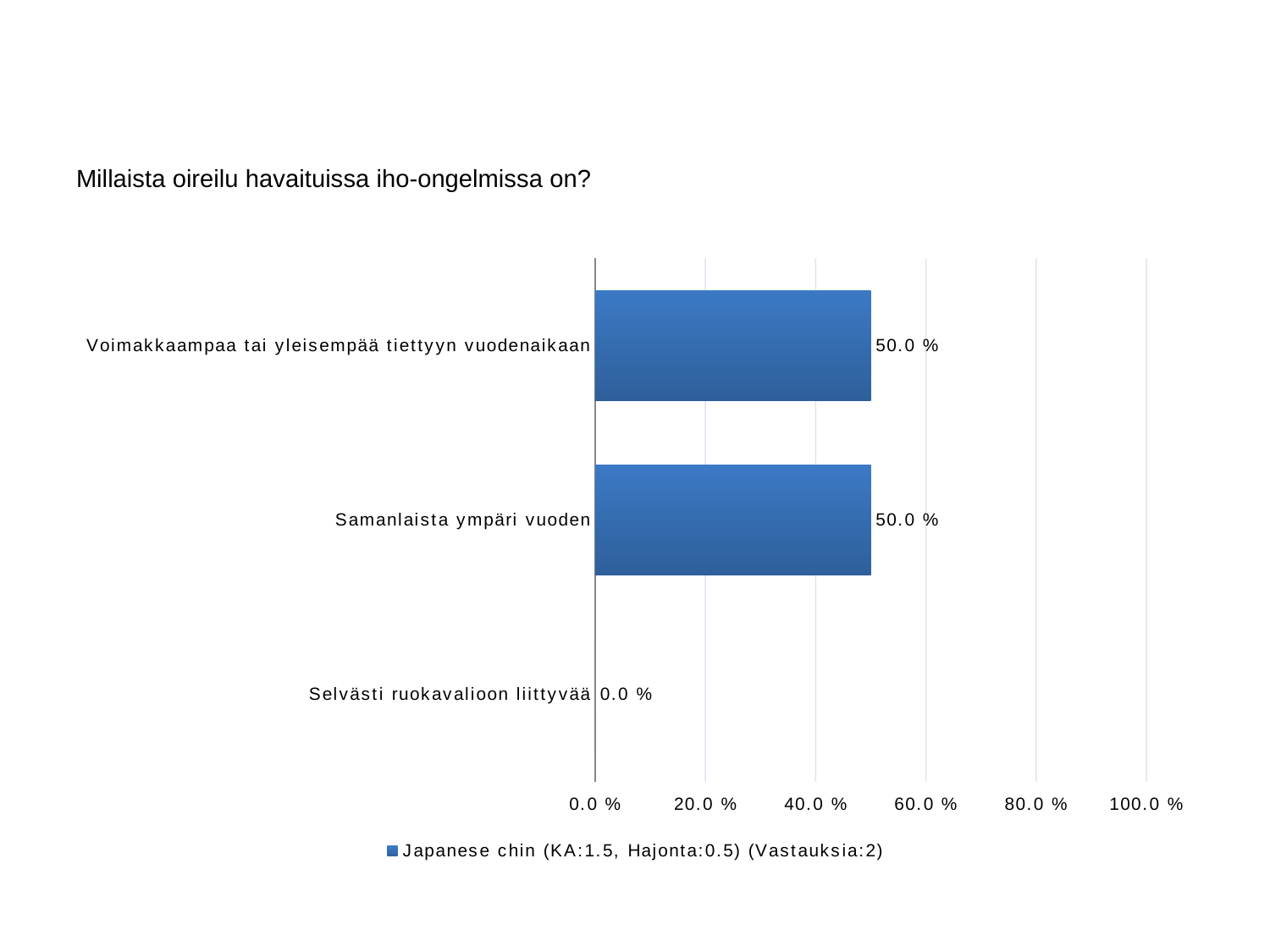
What is the value for "Voimakkaampaa tai yleisempää tiettyyn vuodenaikaan"? 50.0 % What is the value for "Selvästi ruokavalioon liittyvää"? 0.0 % What is the legend entry for the series? Japanese chin (KA:1.5, Hajonta:0.5) (Vastauksia:2) How many categories are shown in the chart? 3 What is the title of the chart? Millaista oireilu havaituissa iho-ongelmissa on? What kind of chart is shown on the slide? Bar chart What is the difference between the values for "Samanlaista ympäri vuoden" and "Selvästi ruokavalioon liittyvää"? 50.0 % What is the value for "Samanlaista ympäri vuoden"? 50.0 % Is the value for "Samanlaista ympäri vuoden" greater or less than 40.0 %? greater Which is larger: the value for "Voimakkaampaa tai yleisempää tiettyyn vuodenaikaan" or for "Selvästi ruokavalioon liittyvää"? Voimakkaampaa tai yleisempää tiettyyn vuodenaikaan Which category has the lowest value? Selvästi ruokavalioon liittyvää How many series does the legend list? 1